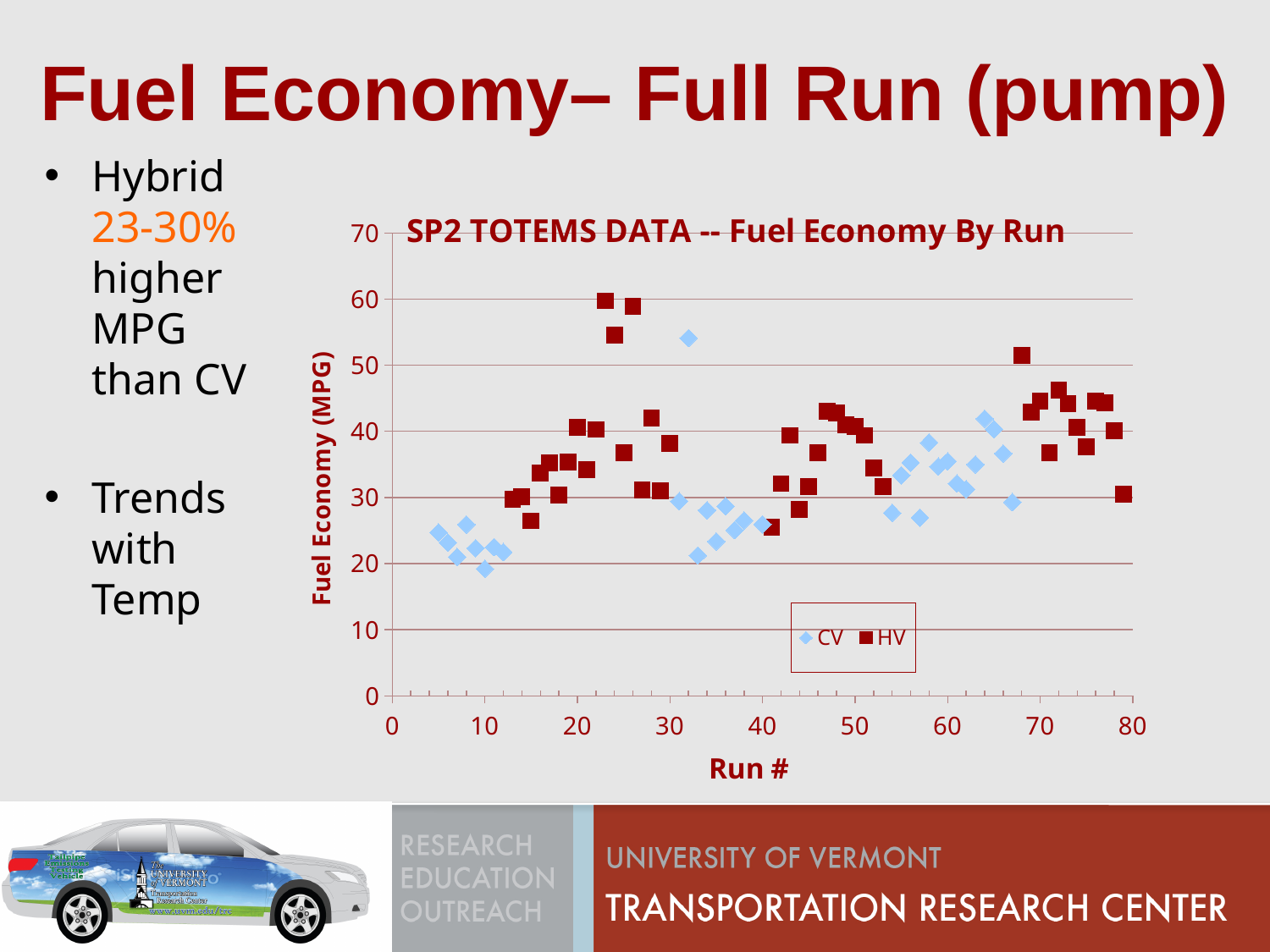
What is the title of the chart? SP2 TOTEMS DATA -- Fuel Economy By Run Which series contains the lowest plotted point on the chart? CV What kind of chart is shown on the slide? Scatter chart Is the CV value at run 33 greater or less than 30? less Which series generally has higher fuel economy values across the runs, CV or HV? HV What are the two series named in the chart's legend? CV and HV Which series contains the highest plotted point on the chart? HV Is the HV value at run 68 greater or less than 40? greater Is the HV value at run 23 greater or less than 50? greater How many series does the chart's legend list? 2